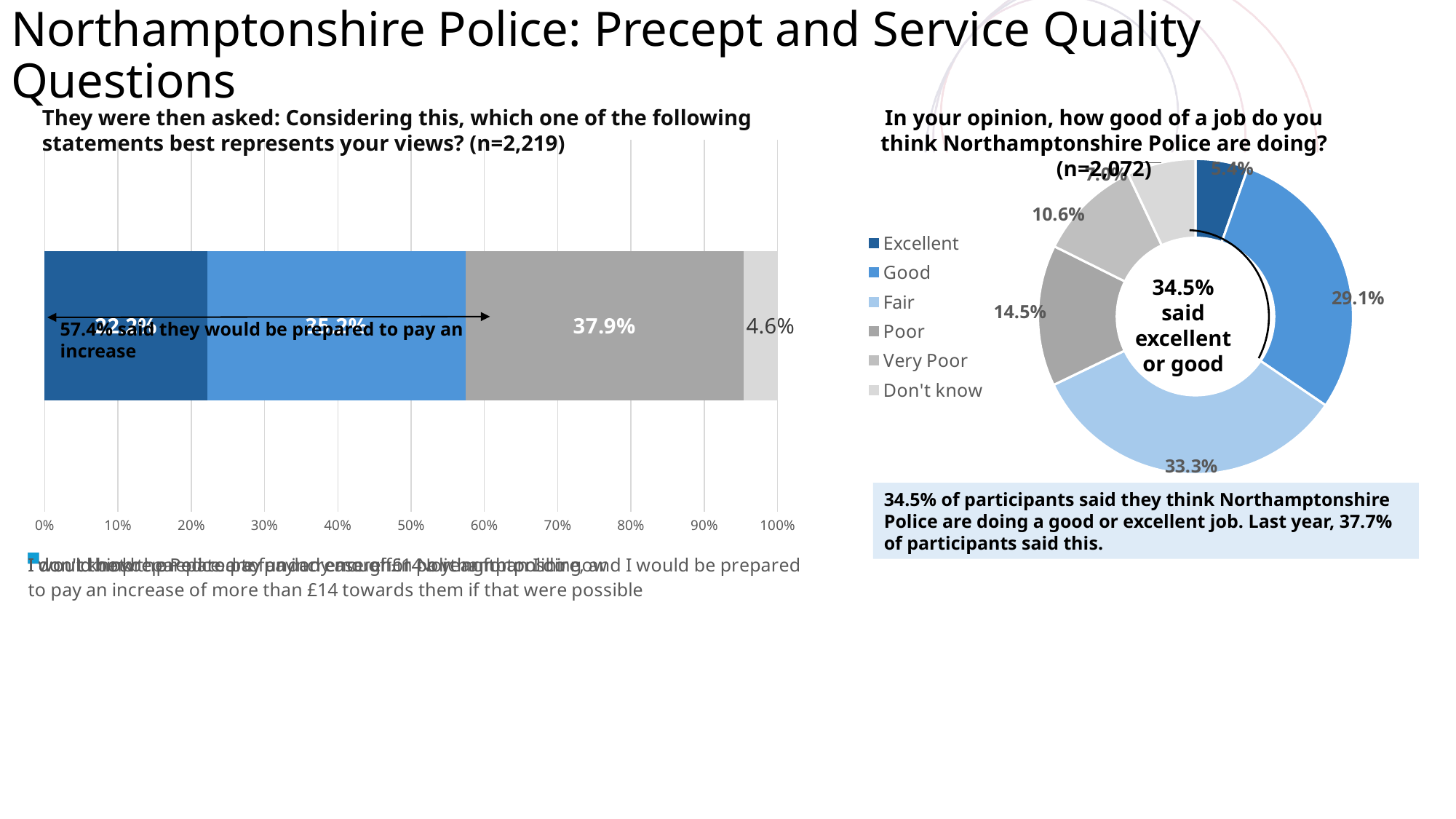
In the doughnut chart on the right, what is the difference between the 'Fair' share and the 'Good' share? 4.2% In the doughnut chart on the right, what percentage of respondents said 'Good'? 29.1% How many entries does the legend of the doughnut chart on the right list? 6 In the doughnut chart on the right, which is larger: the share for 'Good' or the share for 'Poor'? Good What kind of chart is the chart on the left titled 'They were then asked: Considering this, which one of the following statements best represents your views?'? bar chart What text is shown in the centre of the doughnut chart on the right? 34.5% said excellent or good In the doughnut chart on the right, what percentage of respondents said 'Poor'? 14.5% In the doughnut chart on the right, what percentage of respondents said 'Very Poor'? 10.6% In the doughnut chart on the right, what percentage of respondents said 'Fair'? 33.3% In the doughnut chart on the right, which response category has the largest share? Fair What kind of chart is the chart on the right titled 'In your opinion, how good of a job do you think Northamptonshire Police are doing?'? doughnut chart In the stacked bar chart on the left, what value is shown on the dark grey segment? 37.9%